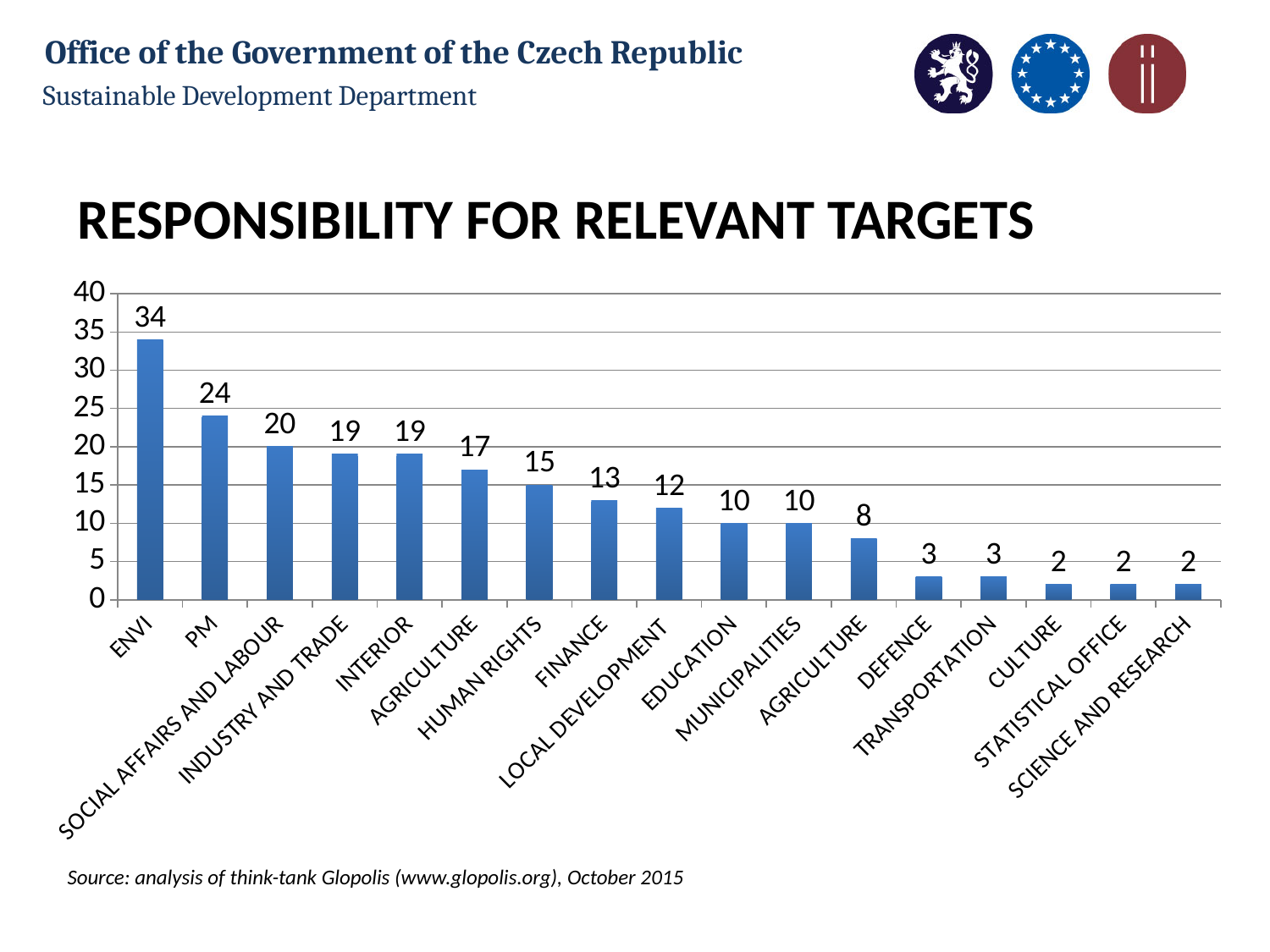
What is the value for ENVI? 34 What is the value for LOCAL DEVELOPMENT? 12 What is the lowest value shown in the chart? 2 What type of chart is shown on the slide? bar chart Which is larger, the value for FINANCE or the value for EDUCATION? FINANCE What is the value for HUMAN RIGHTS? 15 How many categories are shown on the x axis? 17 What is the title of the chart? RESPONSIBILITY FOR RELEVANT TARGETS Do the values generally rise or fall from left to right along the x axis? fall Which category has the highest value? ENVI What is the value for PM? 24 What is the difference between the values for ENVI and PM? 10